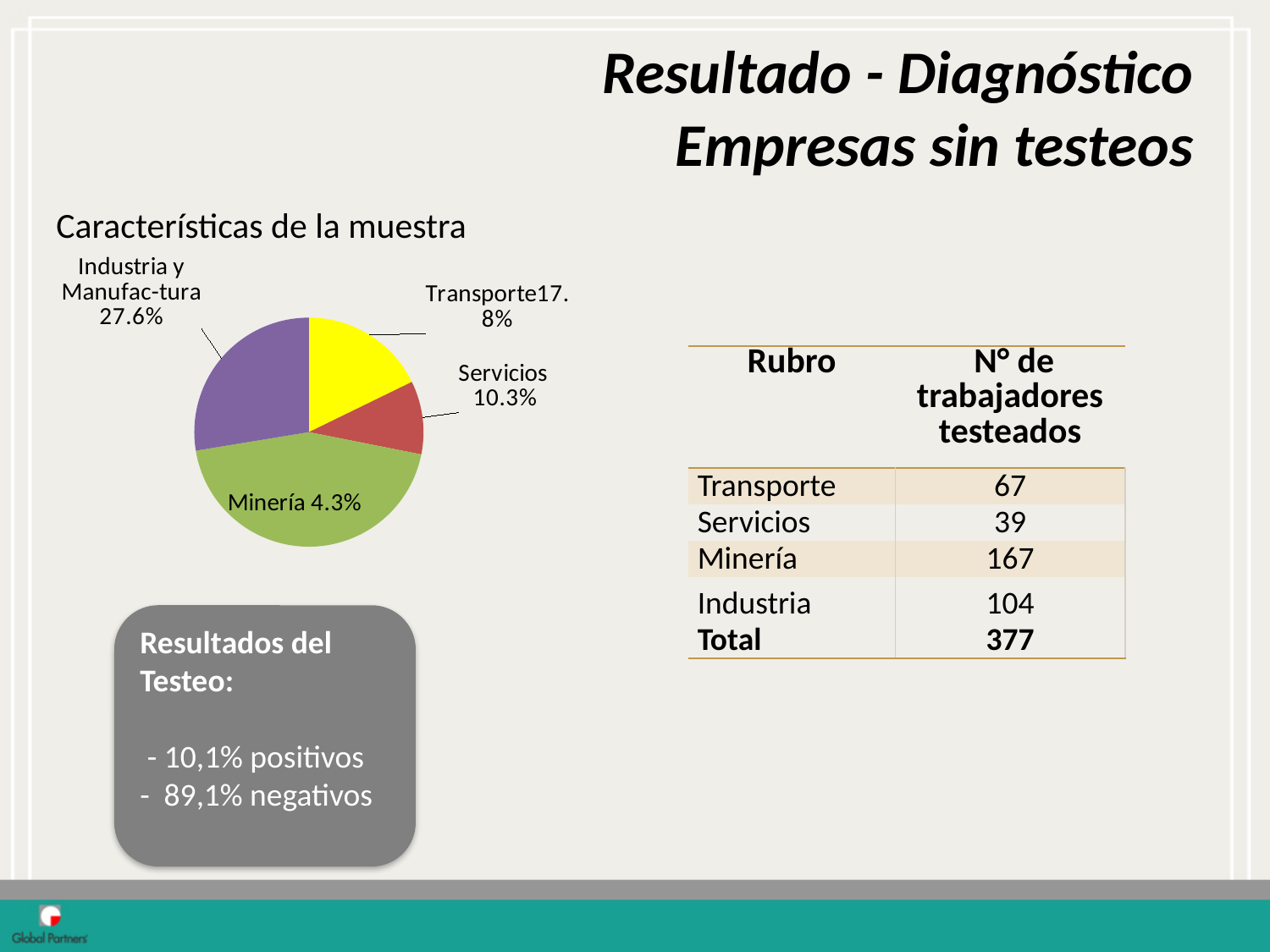
By how many percentage points does the Industria y Manufac-tura share exceed the Transporte share? 9.8 How many slices does the pie chart have? 4 What colour is the Servicios slice in the pie chart? red Which has the larger share in the pie chart, Industria y Manufac-tura or Transporte? Industria y Manufac-tura What percentage does the pie chart show for Transporte? 17.8% By how many percentage points does the Transporte share exceed the Servicios share? 7.5 What percentage label is printed for Minería on the pie chart? 4.3% What percentage does the pie chart show for Industria y Manufac-tura? 27.6% What is the title of the pie chart? Características de la muestra What kind of chart is shown on the slide? pie chart What percentage does the pie chart show for Servicios? 10.3% Which has the larger share in the pie chart, Transporte or Servicios? Transporte